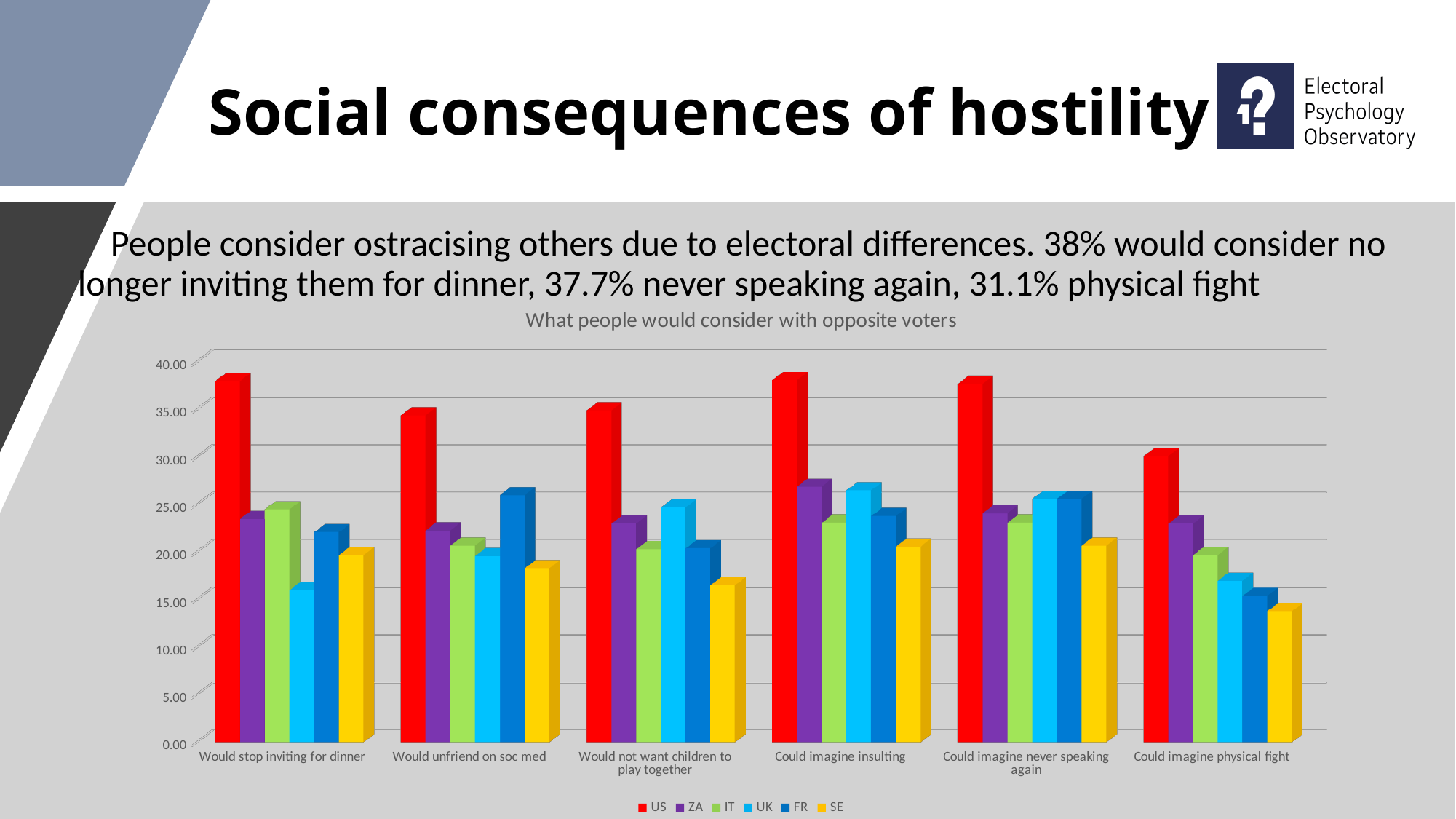
What type of chart is shown on the slide? bar chart What is the title of the chart? What people would consider with opposite voters How many categories are shown on the x axis of the chart? 6 Is the UK value for 'Would stop inviting for dinner' greater or less than 20? less How many series does the chart legend list? 6 Which series is shown in red in the chart? US Which is larger for 'Could imagine insulting', the US value or the ZA value? US Which country has the lowest value for 'Would stop inviting for dinner'? UK For which category is the US value lowest? Could imagine physical fight Is the US value for 'Would stop inviting for dinner' greater or less than 35? greater Which country has the highest value for 'Would stop inviting for dinner'? US Which is larger for 'Would unfriend on soc med', the FR value or the UK value? FR